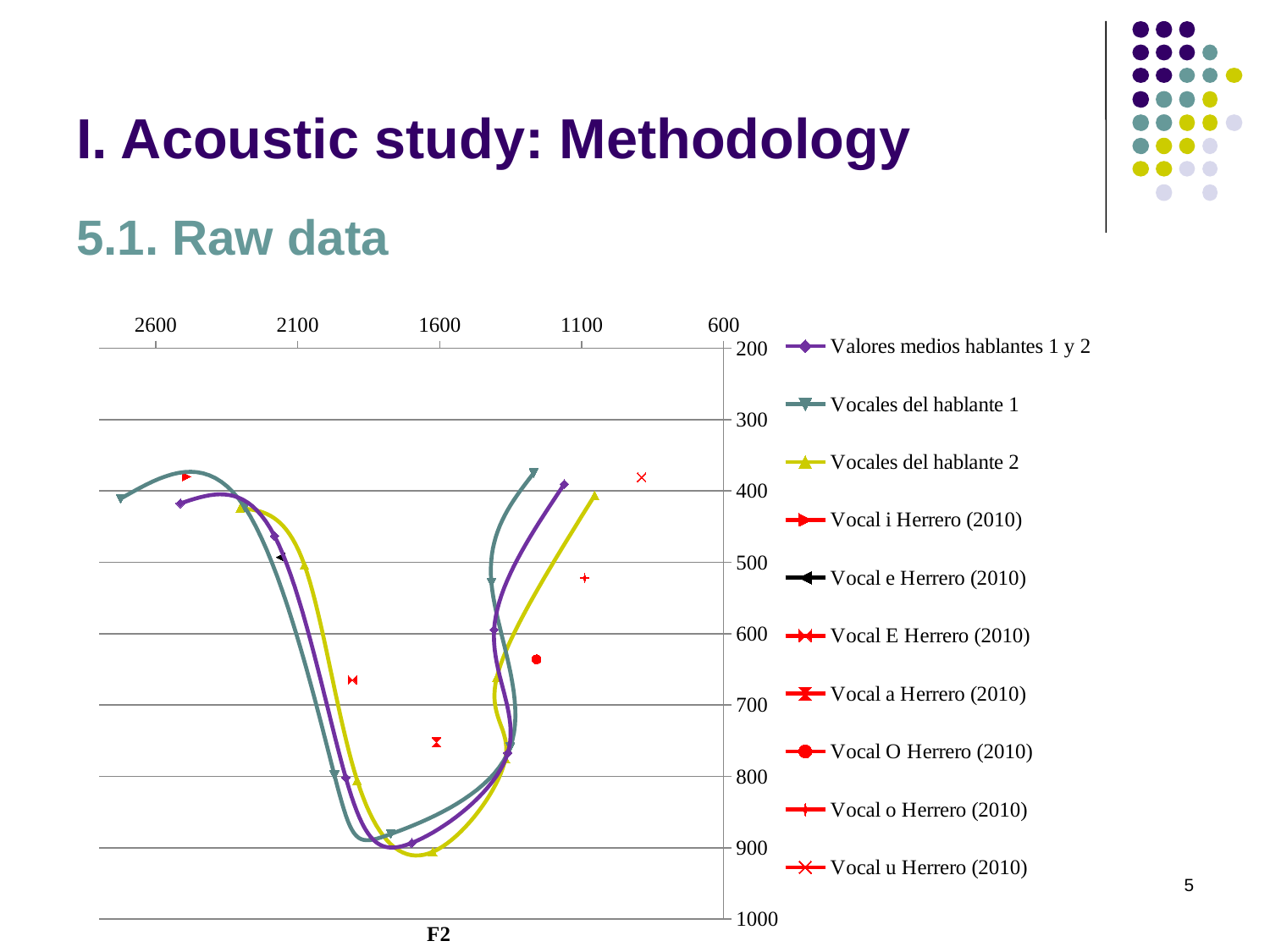
Is the F2 value for Vocal a Herrero (2010) greater or less than 2100? less Is the vertical-axis value for Vocal u Herrero (2010) greater or less than 500? less What is the label on the horizontal axis of the chart? F2 What is the first entry in the chart's legend? Valores medios hablantes 1 y 2 What kind of chart is shown on the slide? scatter chart with smoothed lines Is the F2 value for Vocal i Herrero (2010) greater or less than 2100? greater How many series does the legend list? 10 Which has the larger F2 value, Vocal i Herrero (2010) or Vocal u Herrero (2010)? Vocal i Herrero (2010) Which has the larger vertical-axis value, Vocal a Herrero (2010) or Vocal O Herrero (2010)? Vocal a Herrero (2010)